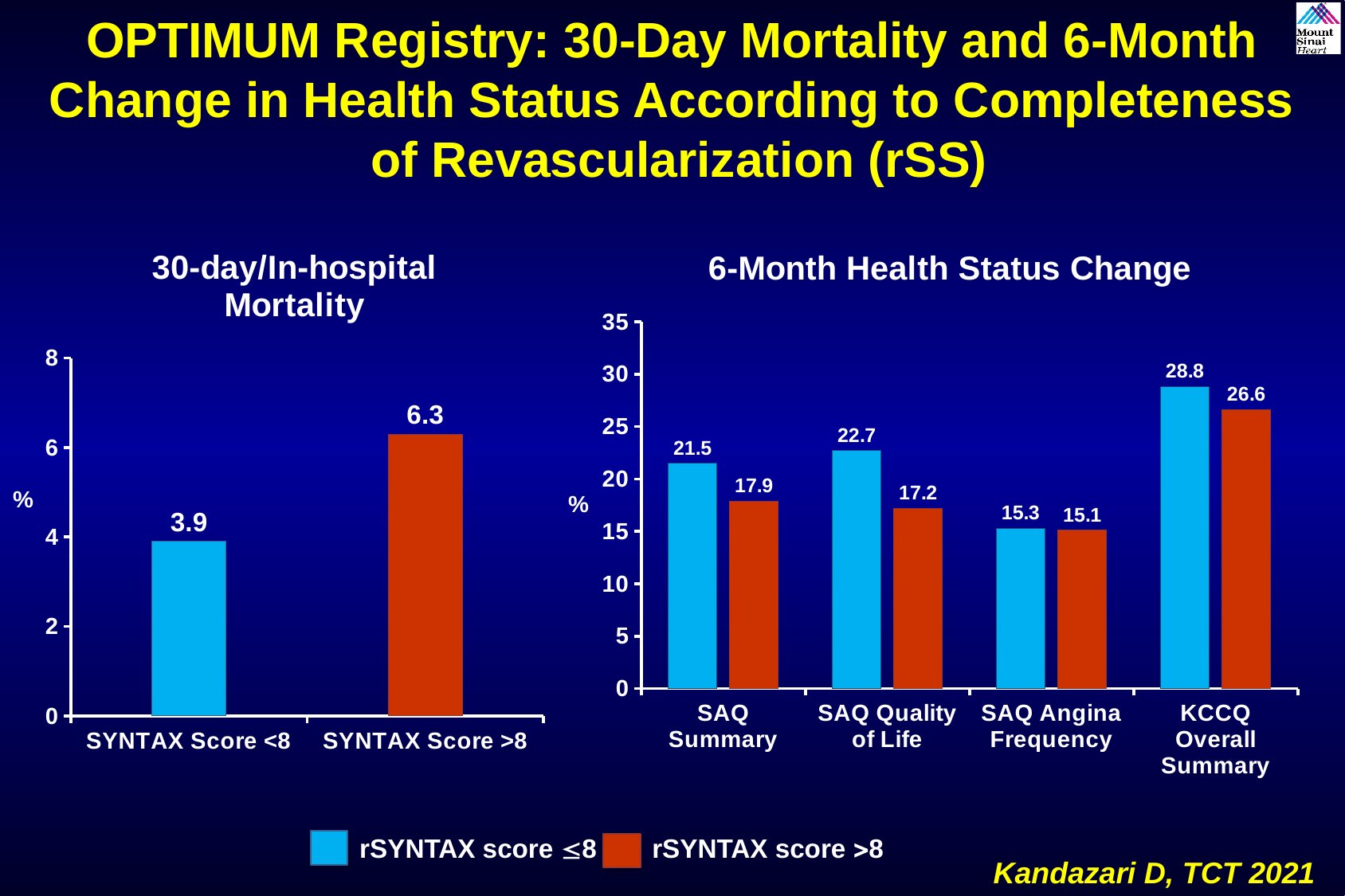
In the 6-Month Health Status Change chart, which is larger for SAQ Summary: rSYNTAX score ≤8 or rSYNTAX score >8? rSYNTAX score ≤8 What kind of chart is the 6-Month Health Status Change chart? Bar chart In the 6-Month Health Status Change chart, which category has the highest value for rSYNTAX score ≤8? KCCQ Overall Summary In the 6-Month Health Status Change chart, which category has the lowest value for rSYNTAX score >8? SAQ Angina Frequency In the 6-Month Health Status Change chart, how many categories are shown on the x axis? 4 In the 6-Month Health Status Change chart, what is the value for rSYNTAX score ≤8 in the SAQ Quality of Life category? 22.7 In the 30-day/In-hospital Mortality chart, what is the difference between the SYNTAX Score >8 and SYNTAX Score <8 values? 2.4 In the 30-day/In-hospital Mortality chart, how many categories are shown on the x axis? 2 In the 30-day/In-hospital Mortality chart, what is the value for SYNTAX Score <8? 3.9 In the 30-day/In-hospital Mortality chart, what is the value for SYNTAX Score >8? 6.3 In the 6-Month Health Status Change chart, what is the value for rSYNTAX score >8 in the KCCQ Overall Summary category? 26.6 In the 6-Month Health Status Change chart, what is the difference between the rSYNTAX score ≤8 and rSYNTAX score >8 values for SAQ Quality of Life? 5.5